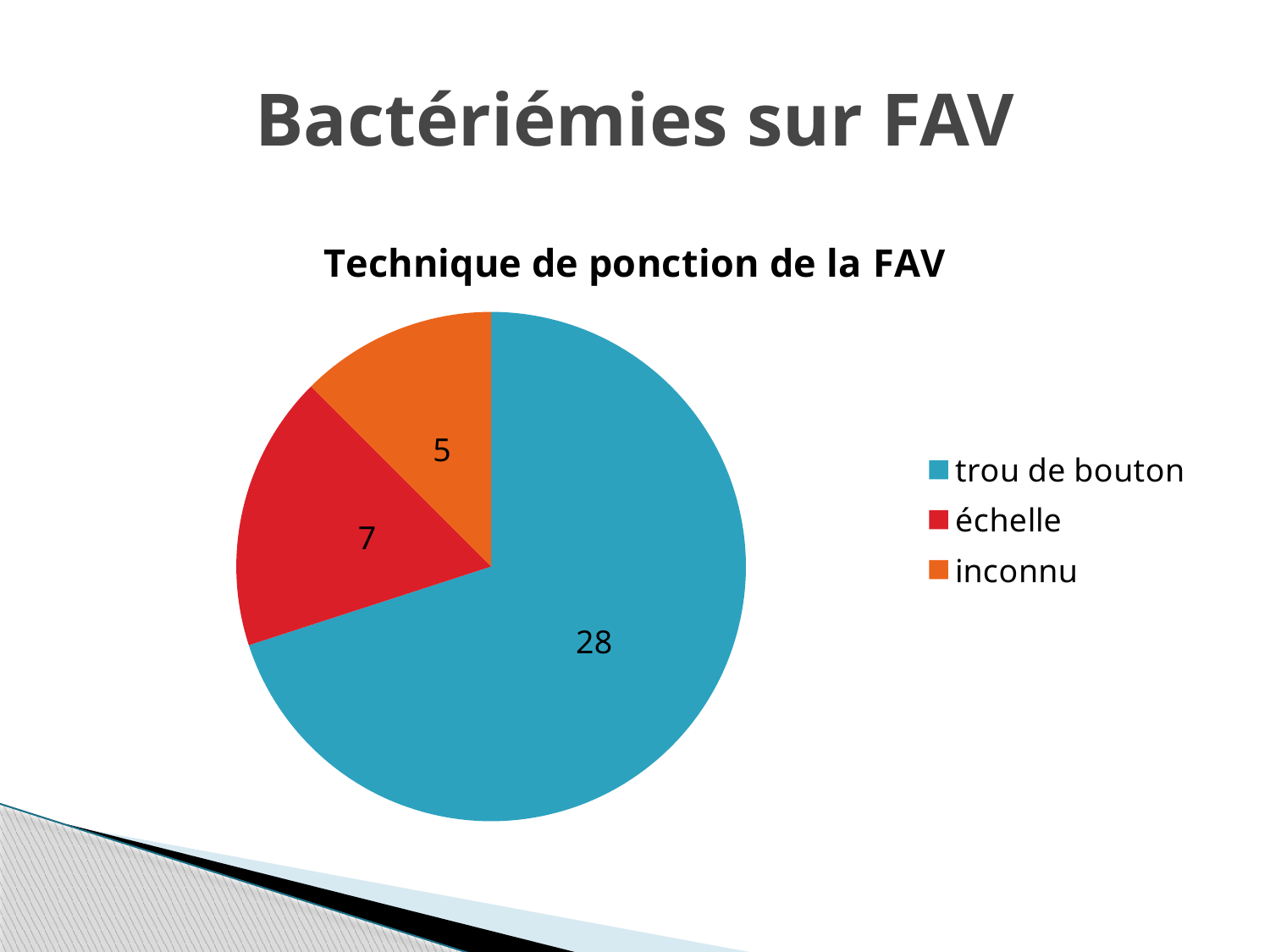
What is the title of the chart? Technique de ponction de la FAV What is the value for échelle? 7 How many categories does the pie chart show? 3 What is the value for trou de bouton? 28 Which is larger, the value for échelle or the value for inconnu? échelle What share of the pie does trou de bouton represent? 70% What is the value for inconnu? 5 What is the difference between the values for trou de bouton and échelle? 21 Which category has the largest slice? trou de bouton What kind of chart is shown on the slide? pie chart Which category has the smallest slice? inconnu What is the difference between the values for échelle and inconnu? 2